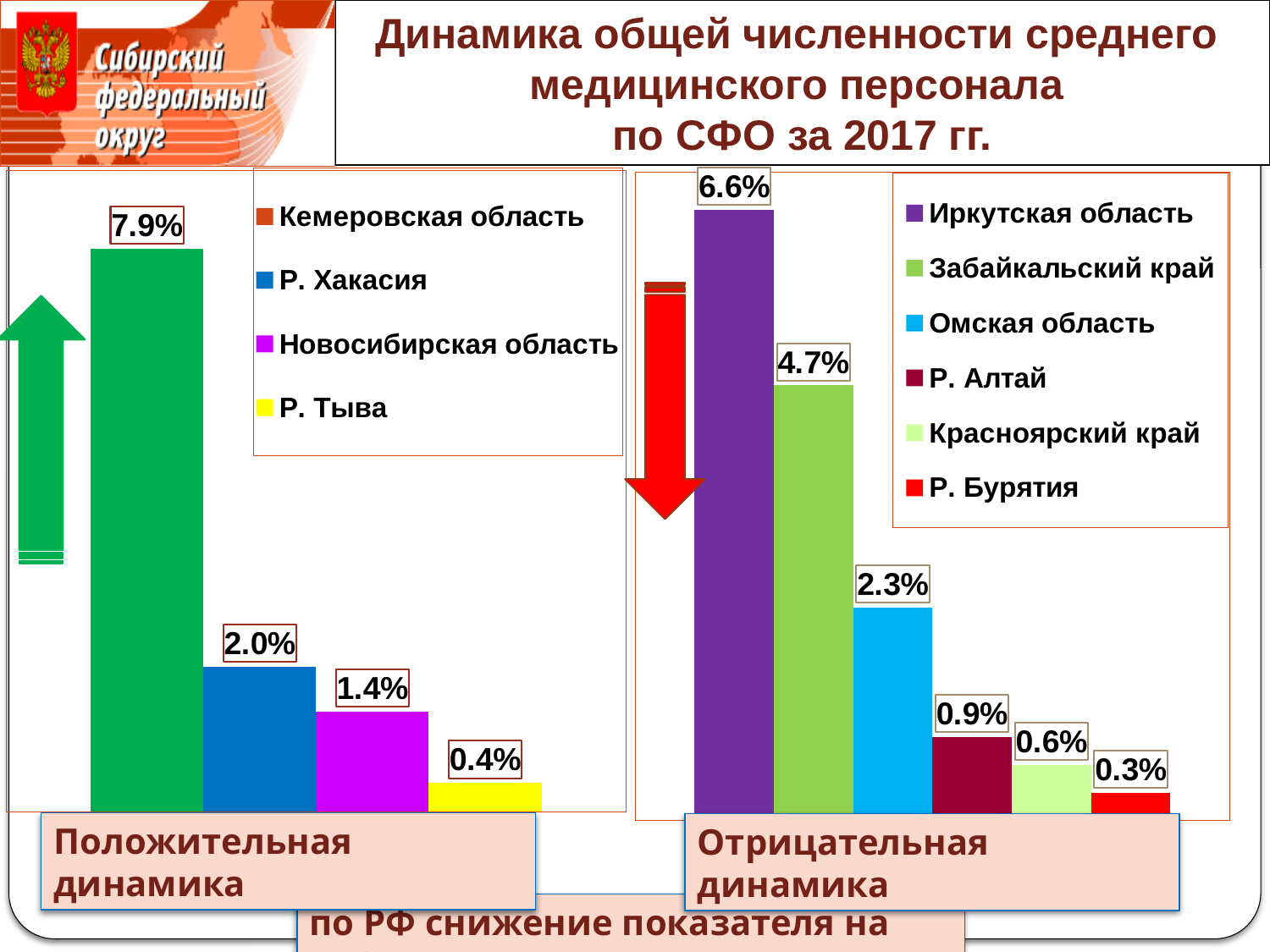
On the left chart (Положительная динамика), what is the value for Р. Тыва? 0.4% On the right chart (Отрицательная динамика), how many bars are plotted? 6 On the right chart (Отрицательная динамика), what is the value for Омская область? 2.3% On the left chart (Положительная динамика), which region has the highest value? Кемеровская область On the right chart (Отрицательная динамика), which region has the lowest value? Р. Бурятия On the right chart (Отрицательная динамика), what is the difference between Иркутская область and Забайкальский край? 1.9% On the left chart (Положительная динамика), how many regions are listed in the legend? 4 On the right chart (Отрицательная динамика), what is the value for Иркутская область? 6.6% On the left chart (Положительная динамика), what is the difference between Р. Хакасия and Новосибирская область? 0.6% On the right chart (Отрицательная динамика), which is larger: Р. Алтай or Красноярский край? Р. Алтай On the left chart (Положительная динамика), what is the value for Кемеровская область? 7.9% What type of chart is used on the right (Отрицательная динамика)? Bar chart